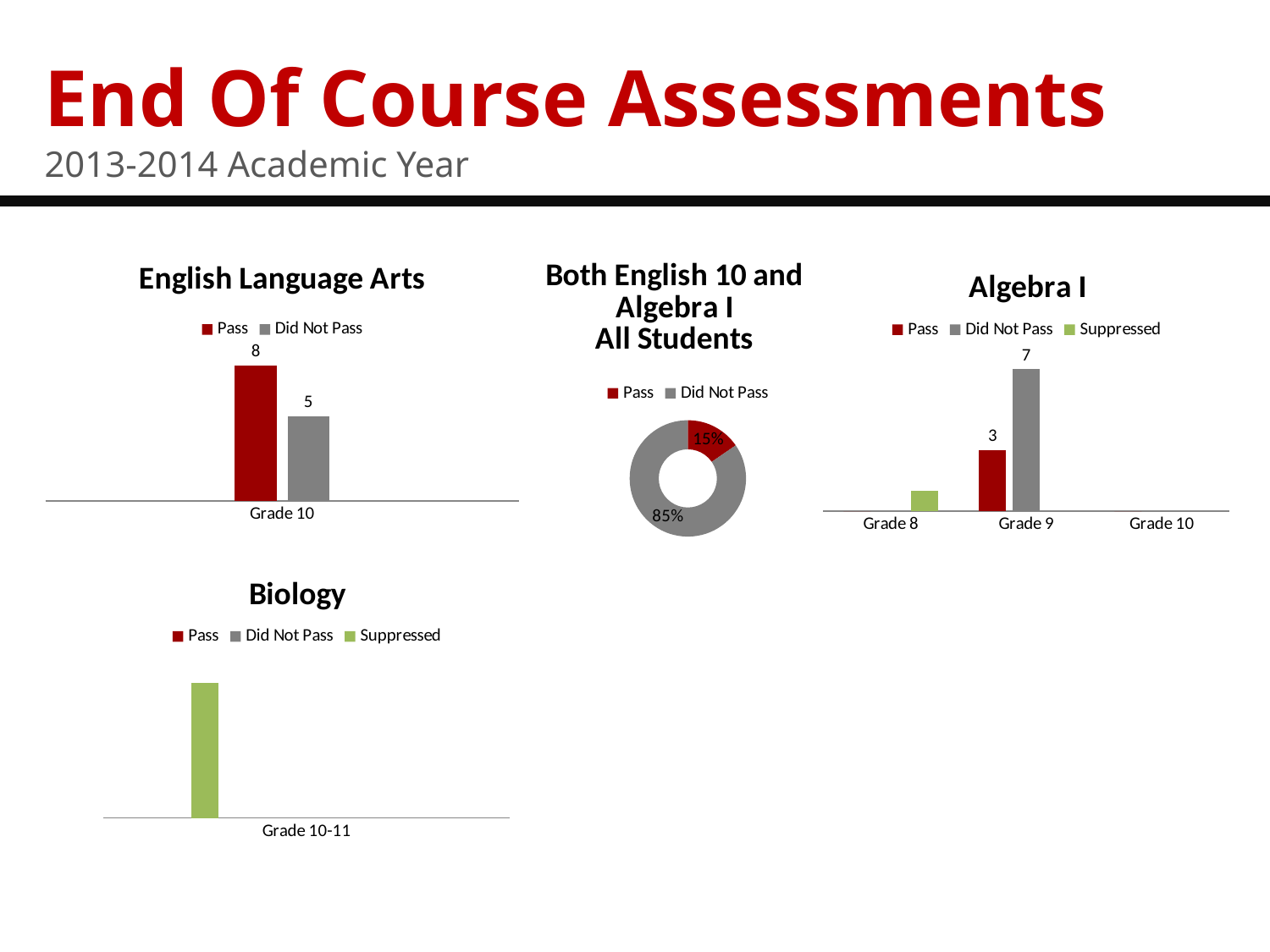
In the Both English 10 and Algebra I All Students chart, what share of students is Did Not Pass? 85% What kind of chart is the Both English 10 and Algebra I All Students chart? Doughnut chart In the English Language Arts chart, what is the value for Pass in Grade 10? 8 In the Algebra I chart, how many series does the legend list? 3 In the Both English 10 and Algebra I All Students chart, what share of students is Pass? 15% In the Algebra I chart, what is the value for Pass in Grade 9? 3 In the English Language Arts chart, which is larger for Grade 10, Pass or Did Not Pass? Pass In the Algebra I chart, what is the value for Did Not Pass in Grade 9? 7 In the English Language Arts chart, what is the value for Did Not Pass in Grade 10? 5 In the Algebra I chart, how many grade categories are shown on the x axis? 3 In the Biology chart, which series has the only bar shown for Grade 10-11? Suppressed In the English Language Arts chart, what is the difference between Pass and Did Not Pass for Grade 10? 3